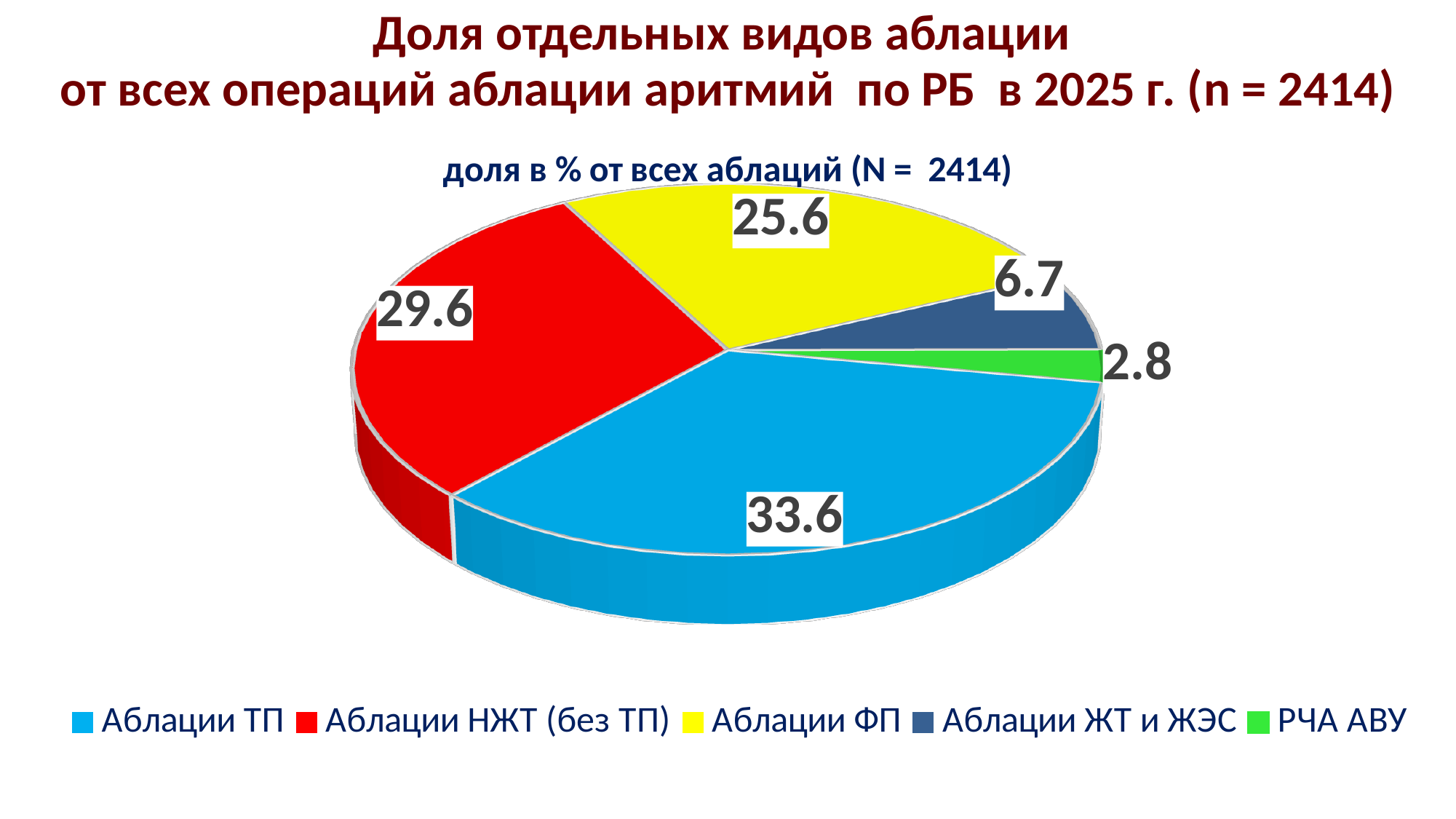
What is the value for Аблации НЖТ (без ТП)? 29.6 What is the title of the chart? доля в % от всех аблаций (N = 2414) Which category has the largest share of the pie? Аблации ТП How many categories does the legend list? 5 What type of chart is shown on the slide? Pie chart Which category has the smallest share of the pie? РЧА АВУ What is the value for Аблации ФП? 25.6 What is the value for РЧА АВУ? 2.8 What is the value for Аблации ТП? 33.6 What is the difference between the values for Аблации ТП and Аблации НЖТ (без ТП)? 4.0 What is the value for Аблации ЖТ и ЖЭС? 6.7 Which is larger, the value for Аблации ФП or the value for Аблации ЖТ и ЖЭС? Аблации ФП